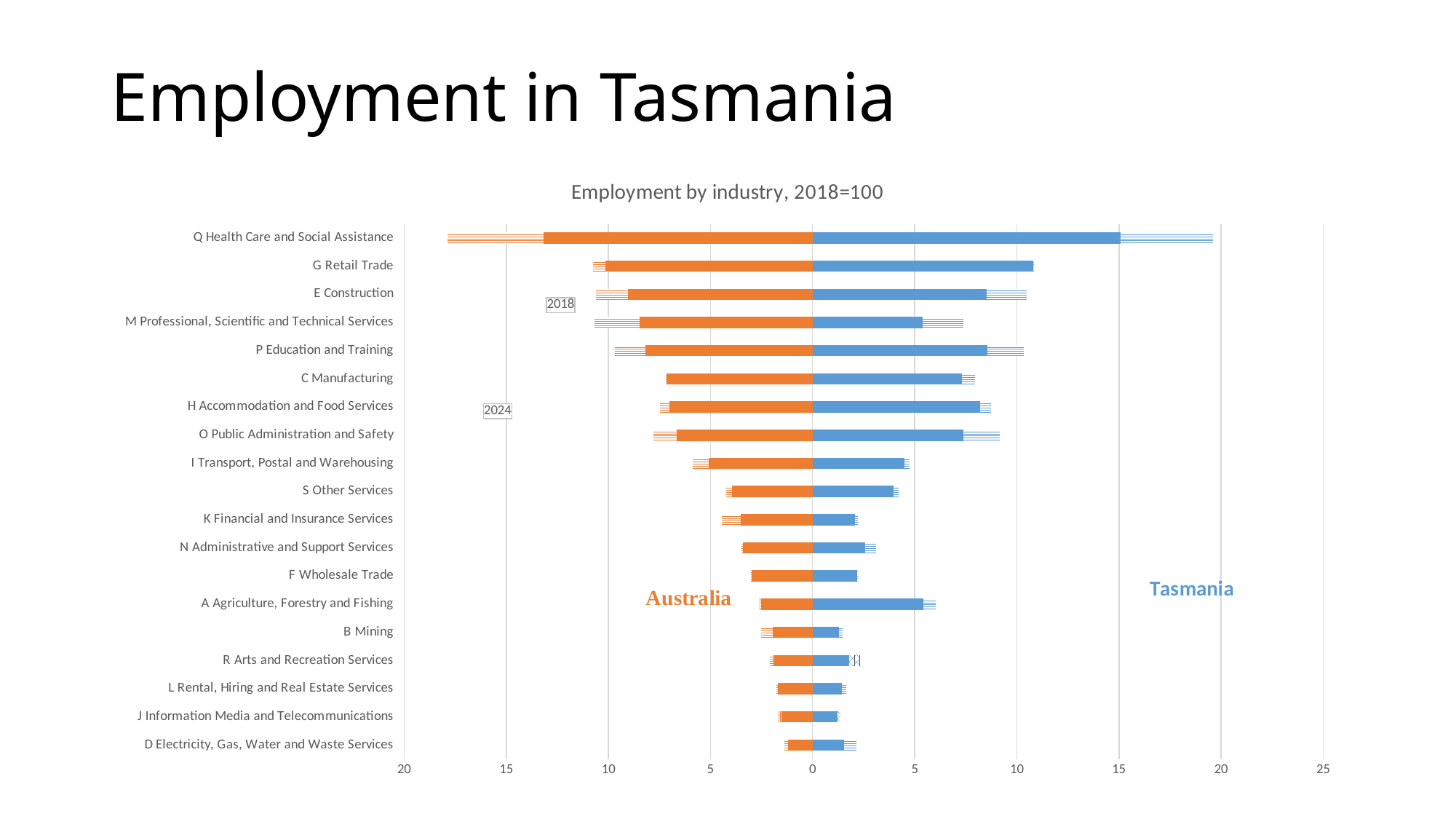
Is the Australia value for E Construction greater or less than 5? greater Is the Tasmania value for F Wholesale Trade greater or less than 5? less Is the Tasmania value for Q Health Care and Social Assistance greater or less than 10? greater What is the title of the chart? Employment by industry, 2018=100 How many industry categories are listed on the chart? 19 Which industry has the highest value for Tasmania? Q Health Care and Social Assistance Which colour represents Australia in the chart? Orange For Tasmania, which is larger: A Agriculture, Forestry and Fishing or B Mining? A Agriculture, Forestry and Fishing Which industry has the highest value for Australia? Q Health Care and Social Assistance How many series (regions) does the chart show? 2 What kind of chart is shown on the slide? Bar chart